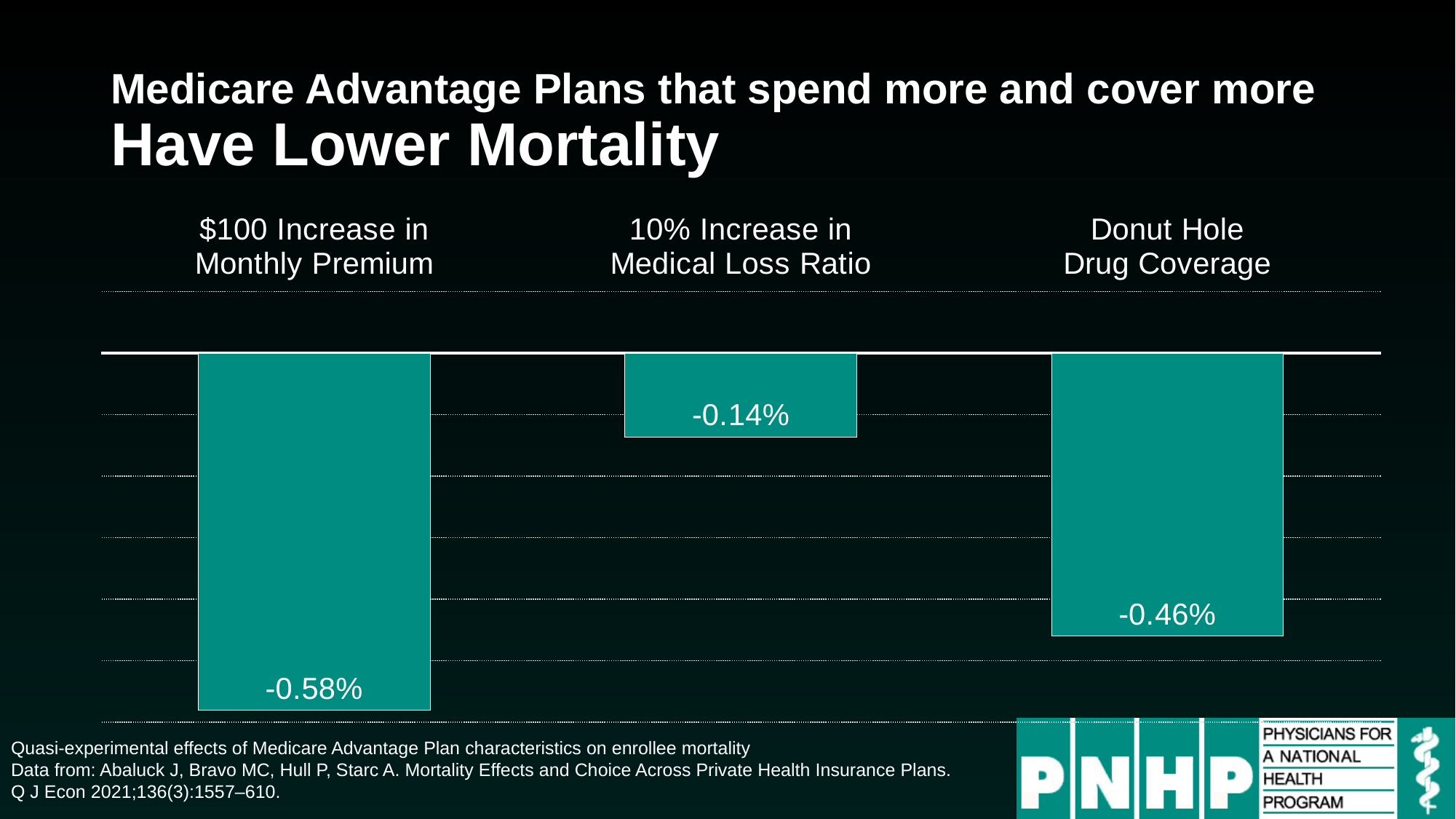
What kind of chart is shown on the slide? Bar chart What colour are the bars in the chart? Teal By how many percentage points does the effect for a $100 Increase in Monthly Premium differ from the effect for Donut Hole Drug Coverage? 0.12 percentage points What is the mortality effect shown for a $100 Increase in Monthly Premium? -0.58% Which category shows the smallest reduction in mortality (the value closest to zero)? 10% Increase in Medical Loss Ratio Which has a larger mortality reduction: Donut Hole Drug Coverage or a 10% Increase in Medical Loss Ratio? Donut Hole Drug Coverage What is the mortality effect shown for Donut Hole Drug Coverage? -0.46% What is the mortality effect shown for a 10% Increase in Medical Loss Ratio? -0.14% How many categories are plotted in the chart? 3 By how many percentage points does the effect for Donut Hole Drug Coverage differ from the effect for a 10% Increase in Medical Loss Ratio? 0.32 percentage points Which has a larger mortality reduction: a $100 Increase in Monthly Premium or Donut Hole Drug Coverage? $100 Increase in Monthly Premium Which category shows the largest reduction in mortality (the most negative value)? $100 Increase in Monthly Premium